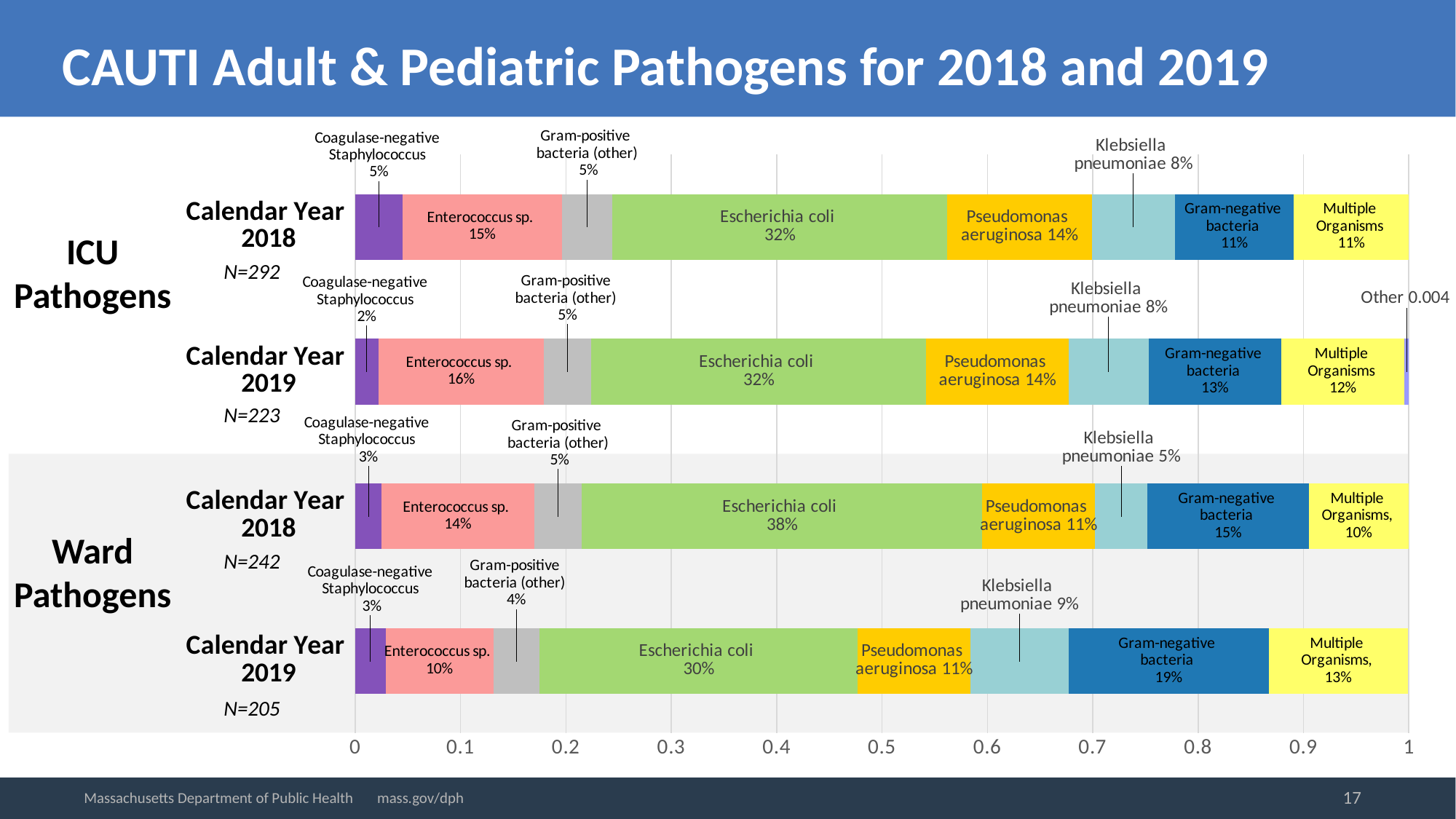
Which pathogen had the smallest share of ICU pathogens in Calendar Year 2019 (excluding 'Other')? Coagulase-negative Staphylococcus How many bars (calendar year groups) are shown in the chart? 4 What is the title of the slide? CAUTI Adult & Pediatric Pathogens for 2018 and 2019 Which was larger for Ward pathogens in Calendar Year 2019: the Enterococcus sp. share or the Multiple Organisms share? Multiple Organisms What share of ICU pathogens in Calendar Year 2018 was Escherichia coli? 32% What share of ICU pathogens in Calendar Year 2019 was Coagulase-negative Staphylococcus? 2% What kind of chart is shown on the slide? Stacked bar chart What share of Ward pathogens in Calendar Year 2018 was Klebsiella pneumoniae? 5% What is the N (number of cases) for ICU pathogens in Calendar Year 2018? N=292 What share of Ward pathogens in Calendar Year 2019 was Gram-negative bacteria? 19% What is the difference in the Escherichia coli share between Ward pathogens in Calendar Year 2018 and Calendar Year 2019? 8% Which pathogen had the largest share of Ward pathogens in Calendar Year 2018? Escherichia coli